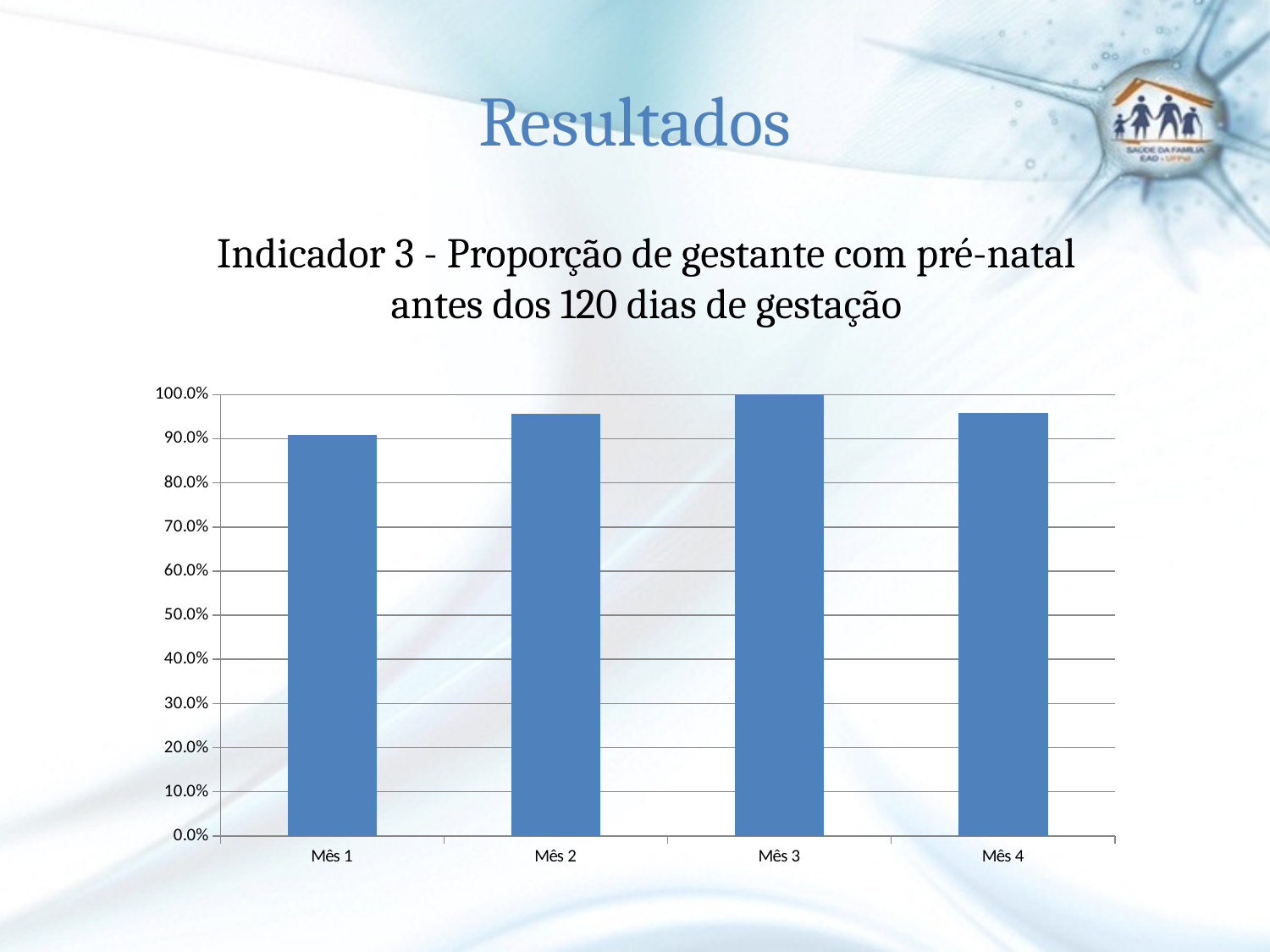
Which month has the lowest proportion on the chart? Mês 1 What is the value for Mês 3? 100.0% What kind of chart is shown on the slide? bar chart Which month has the highest proportion on the chart? Mês 3 Is the value for Mês 1 greater or less than 80.0%? greater How many months (categories) are plotted on the chart? 4 Is the value for Mês 4 greater or less than 100.0%? less What is the highest value shown on the vertical axis of the chart? 100.0% What is the title of the chart on the slide? Indicador 3 - Proporção de gestante com pré-natal antes dos 120 dias de gestação Is the value for Mês 2 greater or less than 90.0%? greater Which is larger, the value for Mês 1 or the value for Mês 3? Mês 3 Which is larger, the value for Mês 1 or the value for Mês 2? Mês 2